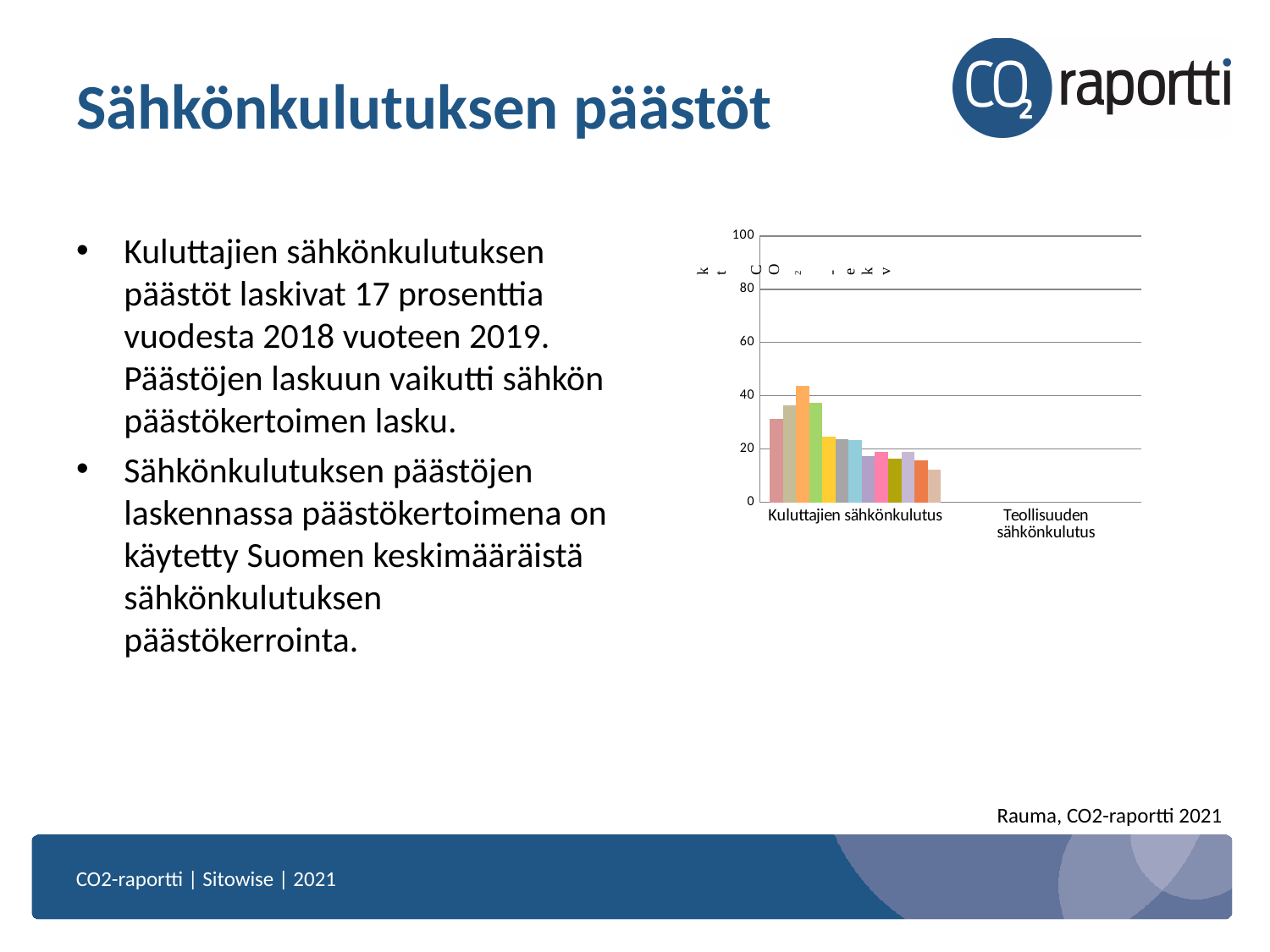
After the tallest bar, do the bars in the Kuluttajien sähkönkulutus group generally rise or fall from left to right? fall Is the tallest bar in the Kuluttajien sähkönkulutus group greater or less than 20? greater What are the two category labels on the x axis of the chart? Kuluttajien sähkönkulutus and Teollisuuden sähkönkulutus Is the leftmost bar in the Kuluttajien sähkönkulutus group taller or shorter than the rightmost bar in that group? taller What is the highest value shown on the y axis of the chart? 100 Is the tallest bar in the Kuluttajien sähkönkulutus group greater or less than 60? less Is the leftmost bar in the Kuluttajien sähkönkulutus group greater or less than 20? greater What kind of chart is shown on the slide? bar chart How many categories are labelled on the x axis of the chart? 2 Which x-axis category has bars plotted in the chart? Kuluttajien sähkönkulutus